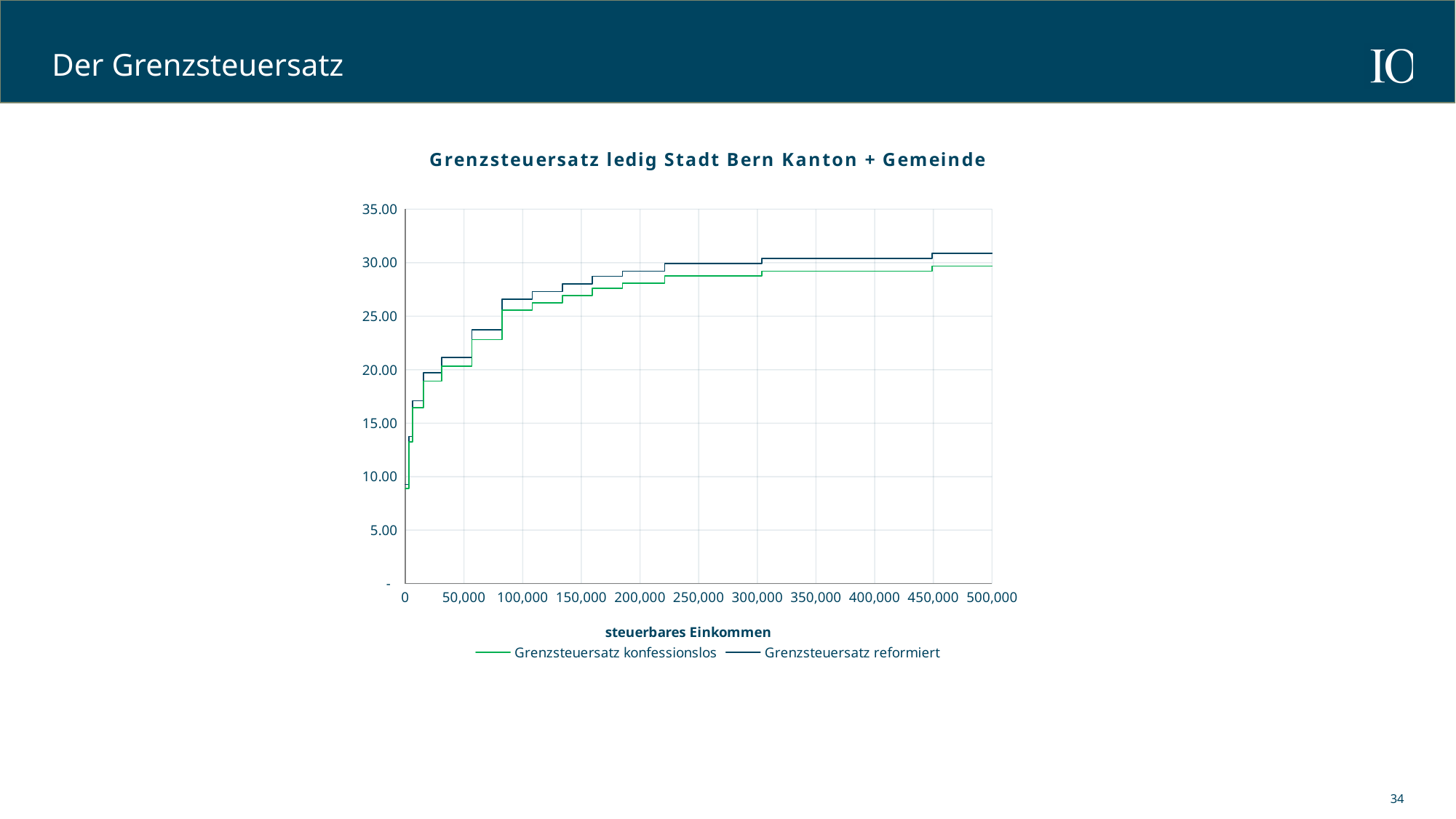
Is the value for Grenzsteuersatz konfessionslos at 500,000 greater or less than 30.00? less Do the values of the Grenzsteuersatz reformiert series rise or fall as steuerbares Einkommen increases? rise Do the values of the Grenzsteuersatz konfessionslos series rise or fall along the x axis? rise What is the title of the chart? Grenzsteuersatz ledig Stadt Bern Kanton + Gemeinde Is the value for Grenzsteuersatz reformiert at 100,000 greater or less than 25.00? greater What is the label of the x axis? steuerbares Einkommen At 400,000 steuerbares Einkommen, which series has the lower value: Grenzsteuersatz konfessionslos or Grenzsteuersatz reformiert? Grenzsteuersatz konfessionslos At 500,000 steuerbares Einkommen, which series has the higher value: Grenzsteuersatz konfessionslos or Grenzsteuersatz reformiert? Grenzsteuersatz reformiert Is the value for Grenzsteuersatz reformiert at 500,000 greater or less than 30.00? greater What kind of chart is shown on the slide? line chart How many series does the legend list? 2